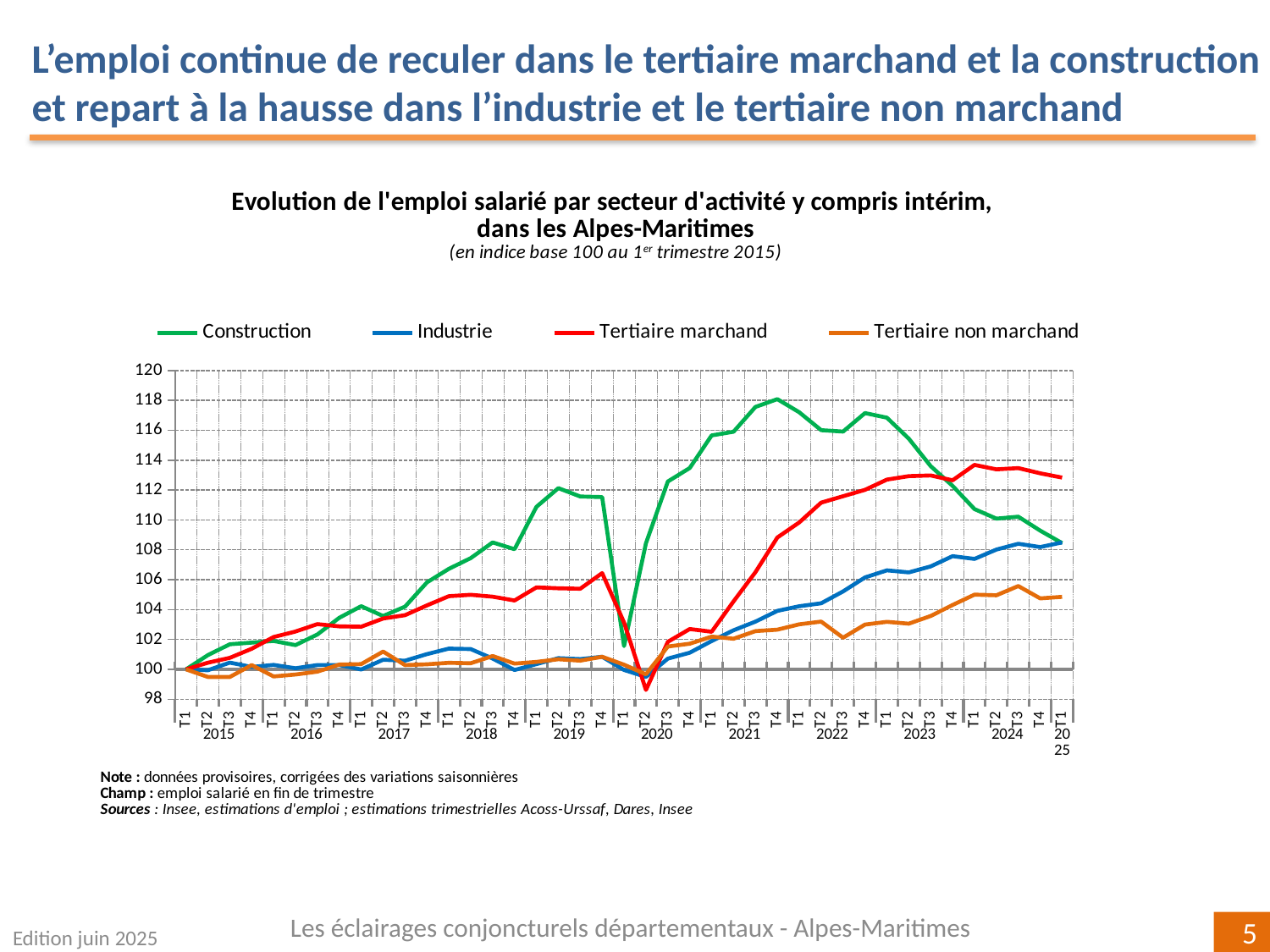
How many series does the legend list? 4 Does the Construction series rise or fall between T1 2023 and T1 2025? fall What is the index value of all series at T1 2015? 100 Is the value for Tertiaire marchand at T2 2020 greater or less than 100? less Which series reaches the highest value anywhere on the chart? Construction Which series are listed in the legend? Construction, Industrie, Tertiaire marchand, Tertiaire non marchand At T1 2025, which is higher: Tertiaire marchand or Construction? Tertiaire marchand Is the value for Tertiaire non marchand at T1 2025 greater or less than 106? less What kind of chart is shown on the slide? line chart At T4 2021, which is higher: Construction or Tertiaire marchand? Construction Is the value for Construction at T4 2021 greater or less than 116? greater Which series has the lowest value at T1 2025? Tertiaire non marchand